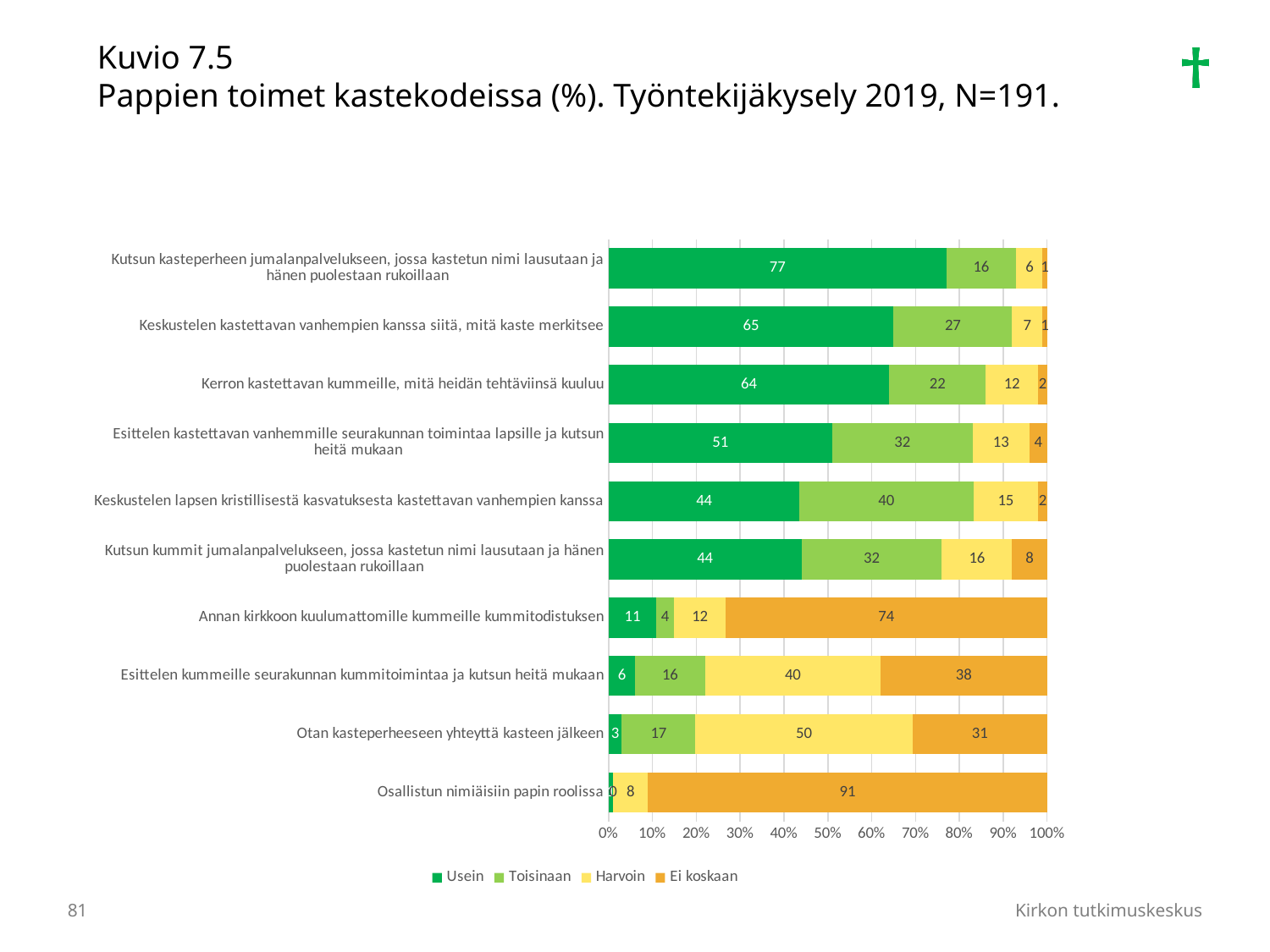
Which category has the highest "Ei koskaan" value? Osallistun nimiäisiin papin roolissa What is the "Harvoin" value for "Otan kasteperheeseen yhteyttä kasteen jälkeen"? 50 What is the "Ei koskaan" value for "Annan kirkkoon kuulumattomille kummeille kummitodistuksen"? 74 Which category has the highest "Usein" value? Kutsun kasteperheen jumalanpalvelukseen, jossa kastetun nimi lausutaan ja hänen puolestaan rukoillaan What percentage of priests answered "Usein" for "Kutsun kasteperheen jumalanpalvelukseen, jossa kastetun nimi lausutaan ja hänen puolestaan rukoillaan"? 77 Which is larger: the "Ei koskaan" value for "Esittelen kummeille seurakunnan kummitoimintaa ja kutsun heitä mukaan" or for "Otan kasteperheeseen yhteyttä kasteen jälkeen"? Esittelen kummeille seurakunnan kummitoimintaa ja kutsun heitä mukaan What is the "Toisinaan" value for "Keskustelen lapsen kristillisestä kasvatuksesta kastettavan vanhempien kanssa"? 40 How many series does the legend list? 4 What is the combined "Usein" and "Toisinaan" value for "Esittelen kastettavan vanhemmille seurakunnan toimintaa lapsille ja kutsun heitä mukaan"? 83 What is the difference between the "Usein" values for "Keskustelen kastettavan vanhempien kanssa siitä, mitä kaste merkitsee" and "Kerron kastettavan kummeille, mitä heidän tehtäviinsä kuuluu"? 1 What kind of chart is shown on the slide? Stacked bar chart How many categories (priest activities) are shown in the chart? 10